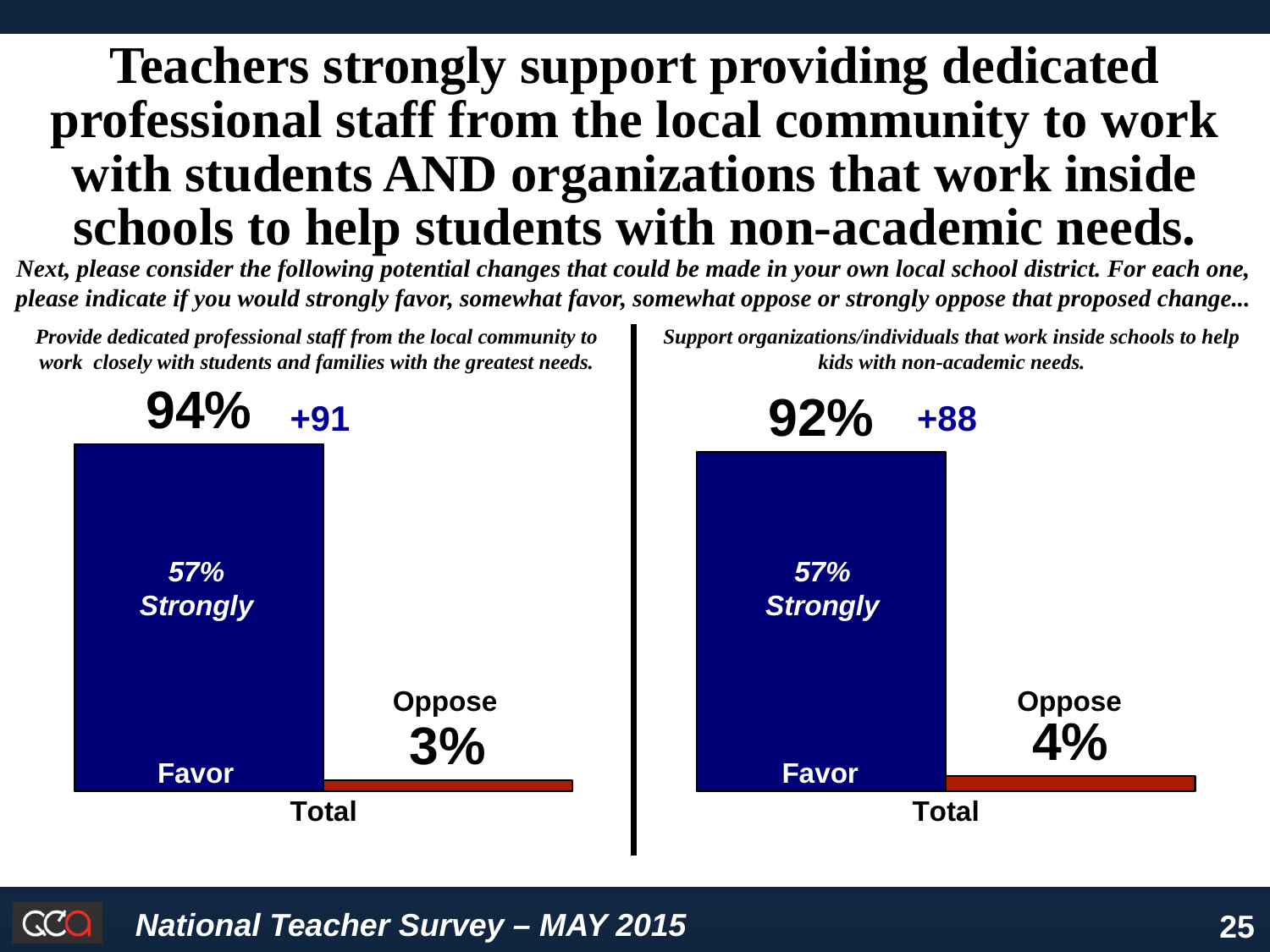
In the left chart, what percentage of teachers favor providing dedicated professional staff from the local community? 94% In the right chart, which is larger, Favor or Oppose? Favor What kind of chart is shown on the left side of the slide? Bar chart In the right chart, what percentage of teachers favor supporting organizations/individuals that work inside schools? 92% In the right chart, what share of teachers strongly favor the change? 57% In the left chart, what percentage of teachers oppose the proposed change? 3% In the right chart, what is the net favor figure shown next to the Favor percentage? +88 In the left chart, what share of teachers strongly favor the change? 57% In the left chart, what is the difference between the Favor and Oppose percentages? 91 percentage points In the left chart, what is the net favor figure shown next to the Favor percentage? +91 In the right chart, what colour is the Oppose bar? Red In the right chart, what percentage of teachers oppose the proposed change? 4%